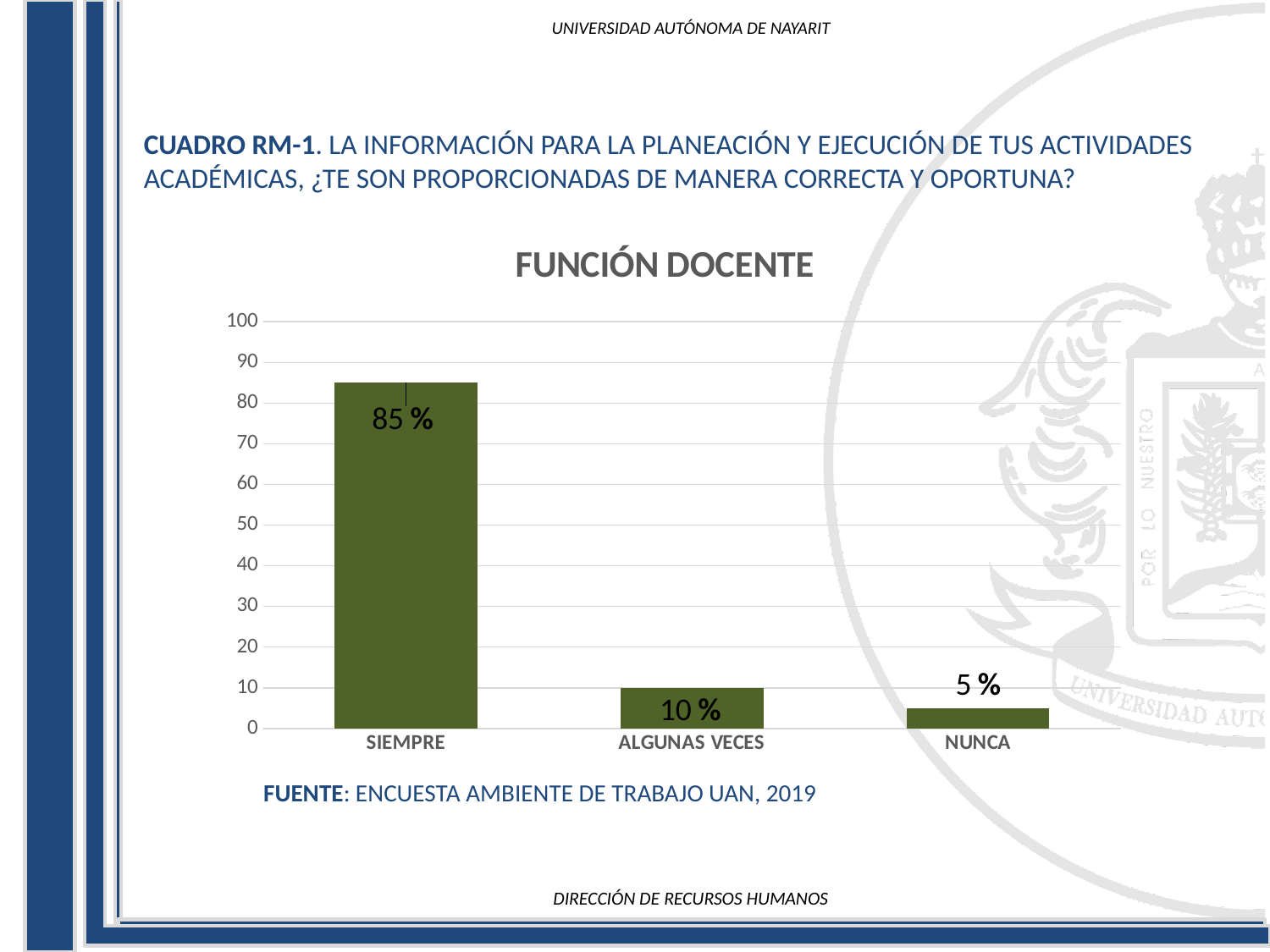
What is the title of the chart? FUNCIÓN DOCENTE How many categories are shown on the x axis? 3 What is the value for ALGUNAS VECES? 10 % What is the difference between the values for SIEMPRE and ALGUNAS VECES? 75 % Is the value for SIEMPRE greater or less than 80? greater Which category has the highest value? SIEMPRE What is the difference between the values for ALGUNAS VECES and NUNCA? 5 % Which is larger, the value for ALGUNAS VECES or the value for NUNCA? ALGUNAS VECES What is the value for NUNCA? 5 % What is the value for SIEMPRE? 85 % Which category has the lowest value? NUNCA What kind of chart is shown on the slide? bar chart